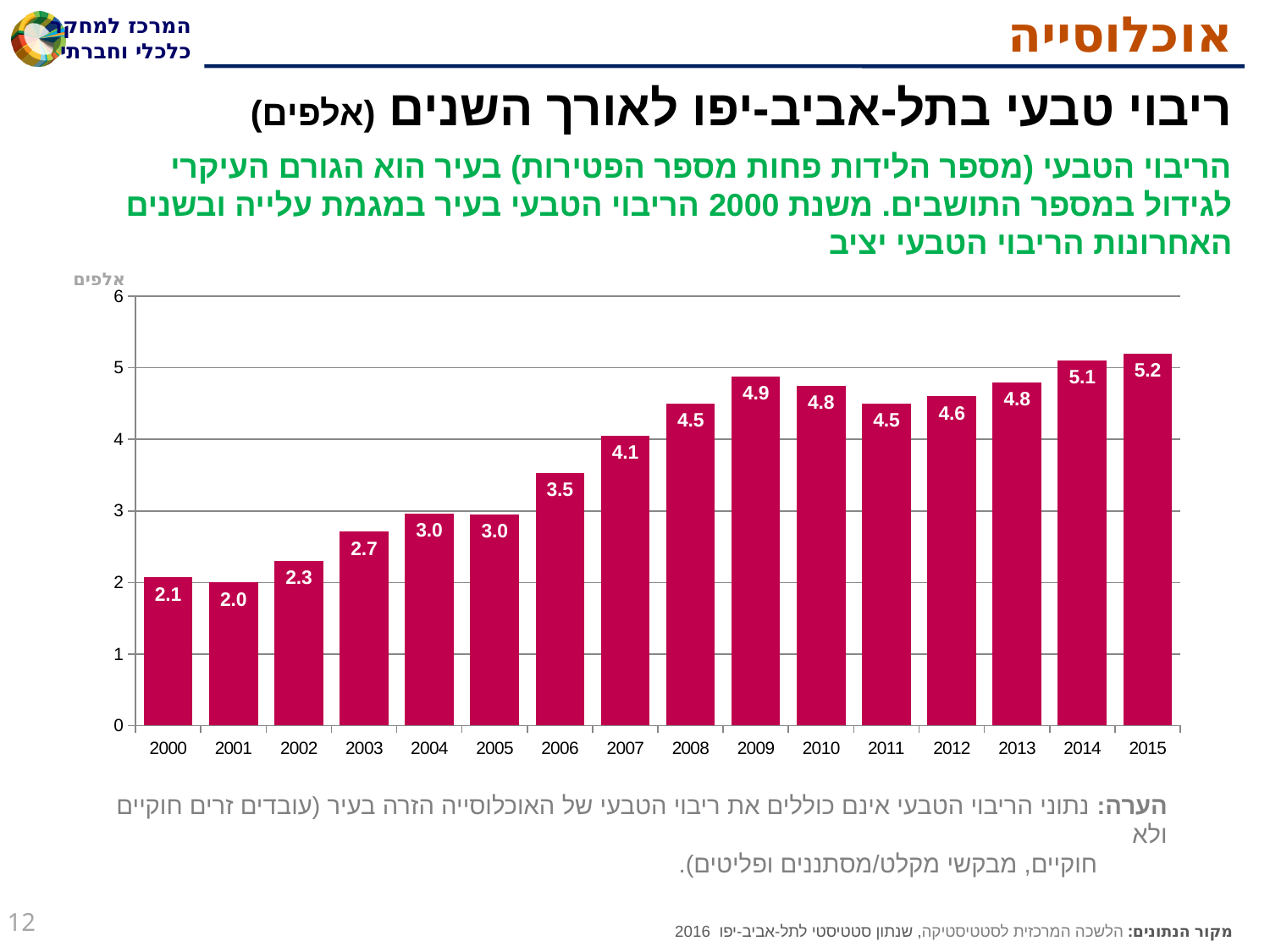
Which is larger, the value for 2009 or the value for 2010? 2009 What is the value for 2009? 4.9 Do the values generally rise or fall from 2000 to 2015? rise What kind of chart is shown on the slide? bar chart What is the value for 2000? 2.1 Which year has the highest value? 2015 Is the value for 2007 greater or less than 4? greater Which year has the lowest value? 2001 What is the difference between the values for 2015 and 2000? 3.1 What is the value for 2015? 5.2 What is the difference between the values for 2014 and 2013? 0.3 How many years are shown on the x axis? 16